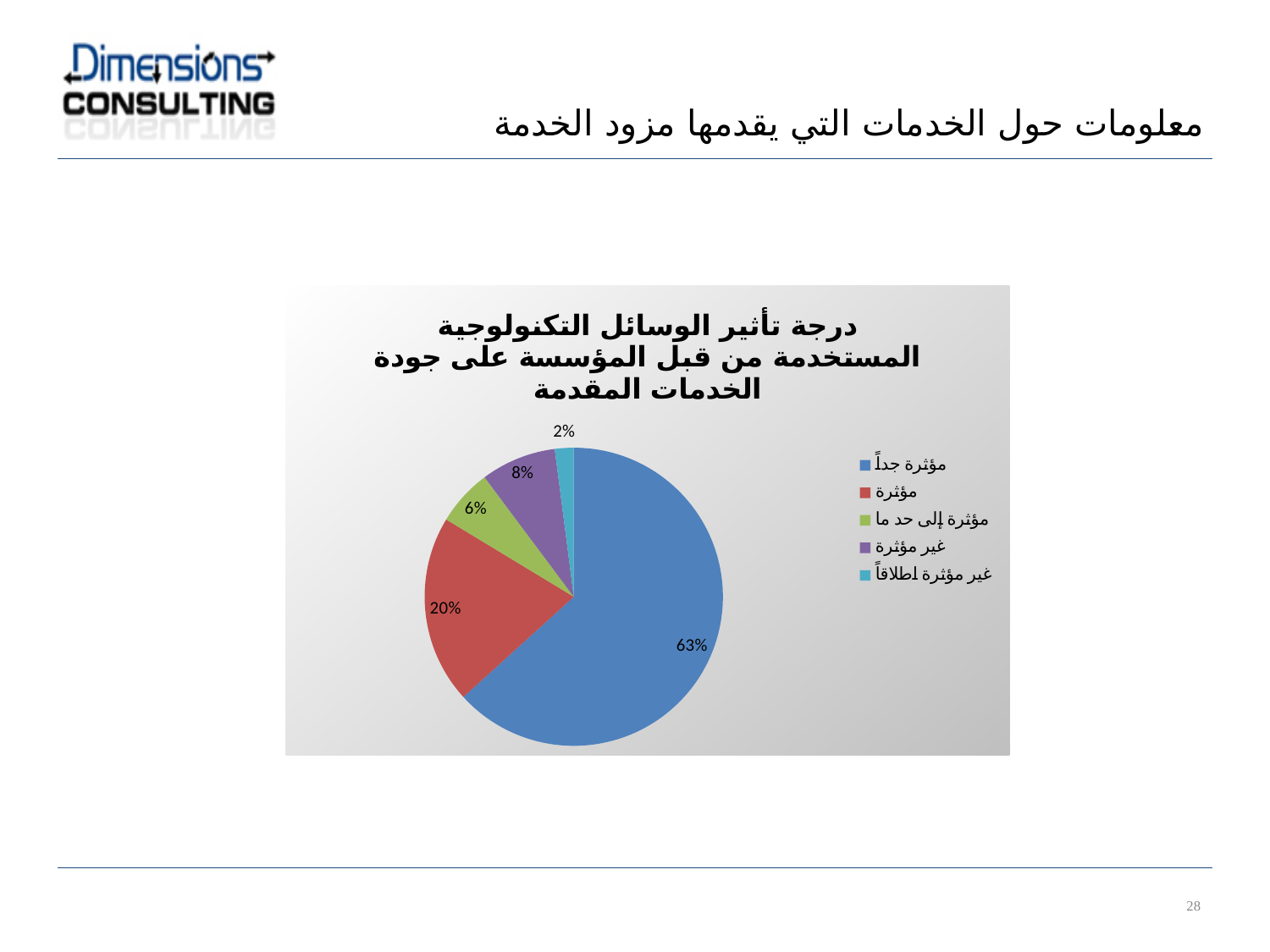
What kind of chart is shown on the slide? pie chart Which category has the smallest slice of the pie? غير مؤثرة اطلاقاً Which is larger, the slice for "غير مؤثرة" or the slice for "مؤثرة إلى حد ما"? غير مؤثرة What share of the pie does "غير مؤثرة" have? 8% What is the difference in percentage points between "مؤثرة جداً" and "مؤثرة"? 43 Which category has the largest slice of the pie? مؤثرة جداً What colour is the slice for "مؤثرة"? red What share of the pie does "مؤثرة جداً" have? 63% What share of the pie does "غير مؤثرة اطلاقاً" have? 2% What share of the pie does "مؤثرة إلى حد ما" have? 6% What share of the pie does "مؤثرة" have? 20% How many categories does the legend of the pie chart list? 5